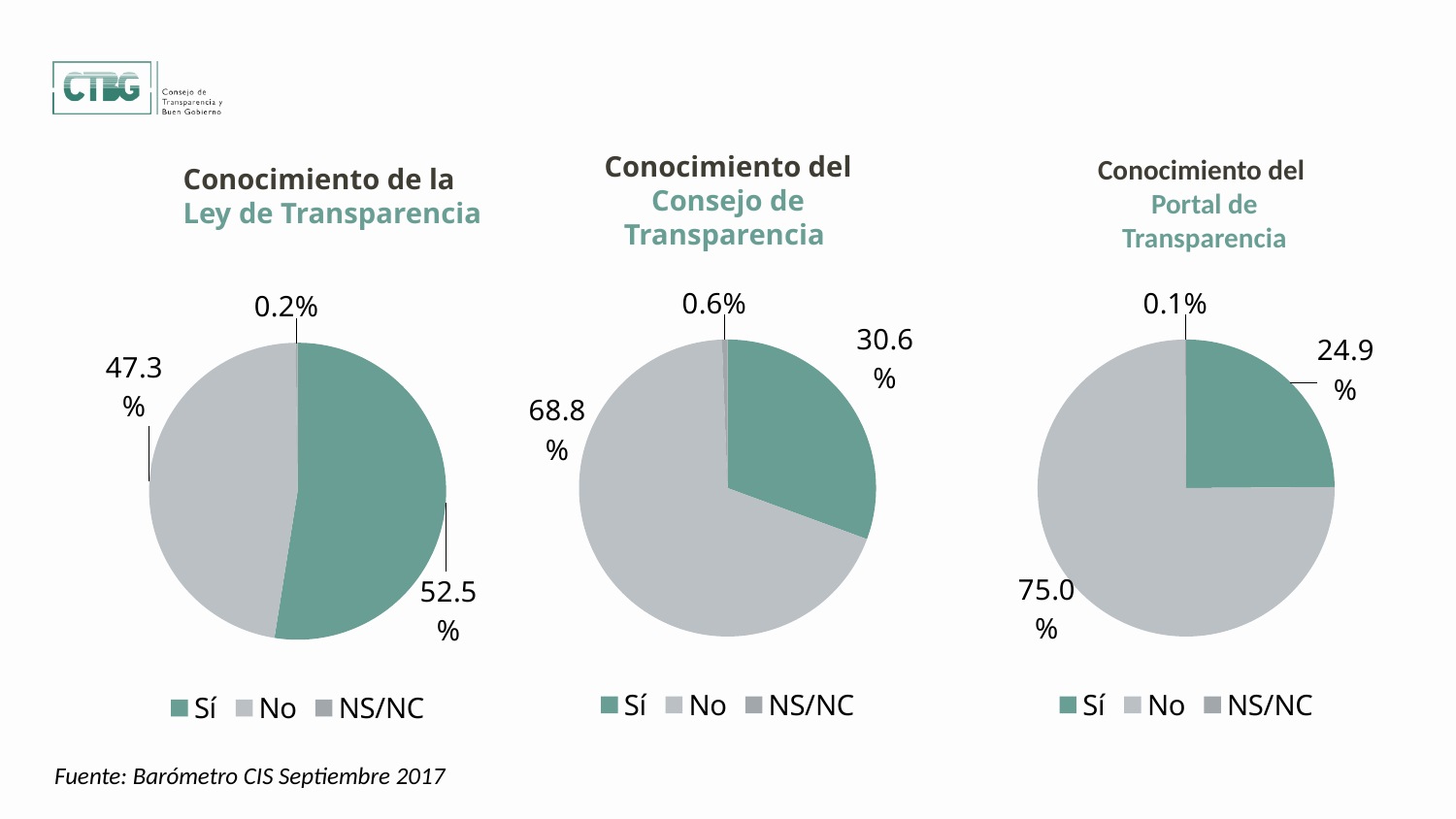
How many pie charts are shown on the slide? 3 In the 'Conocimiento del Portal de Transparencia' pie chart, which category has the largest share? No In the 'Conocimiento de la Ley de Transparencia' pie chart, which category has the smallest share? NS/NC In the 'Conocimiento del Consejo de Transparencia' pie chart, what is the difference between the No and Sí values? 38.2% What kind of chart is used for 'Conocimiento del Portal de Transparencia'? Pie chart In the 'Conocimiento del Consejo de Transparencia' pie chart, what is the value for NS/NC? 0.6% In the 'Conocimiento del Portal de Transparencia' pie chart, what is the value for Sí? 24.9% In the 'Conocimiento de la Ley de Transparencia' pie chart, what is the value for No? 47.3% In the 'Conocimiento del Consejo de Transparencia' pie chart, what is the value for No? 68.8% In the 'Conocimiento de la Ley de Transparencia' pie chart, what is the value for Sí? 52.5% In the 'Conocimiento de la Ley de Transparencia' pie chart, which is larger, Sí or No? Sí How many series does the legend of the 'Conocimiento del Consejo de Transparencia' chart list? 3